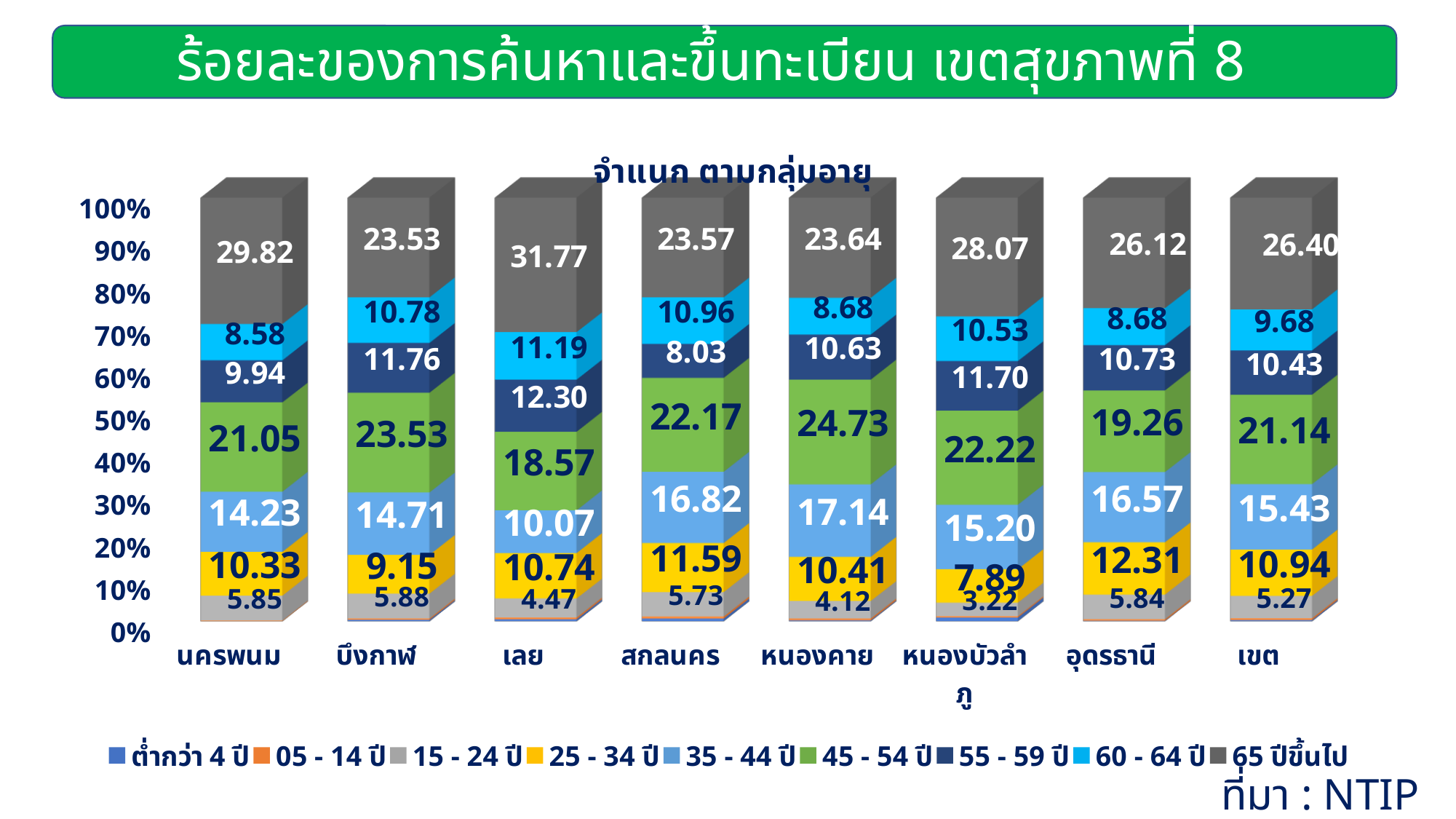
Which has the larger 35 - 44 ปี value, หนองคาย or สกลนคร? หนองคาย How many series does the legend list? 9 Which category has the lowest value for the 15 - 24 ปี series? หนองบัวลำภู Which category has the highest value for the 35 - 44 ปี series? หนองคาย What is the difference between the 45 - 54 ปี values for บึงกาฬ and เลย? 4.96 How many categories are shown on the x axis? 8 What is the value for the 65 ปีขึ้นไป series for เลย? 31.77 What kind of chart is shown on the slide? Stacked bar chart What is the value for the 25 - 34 ปี series for อุดรธานี? 12.31 Which category has the highest value for the 65 ปีขึ้นไป series? เลย What is the subtitle printed above the chart? จำแนก ตามกลุ่มอายุ What is the value for the 45 - 54 ปี series for หนองคาย? 24.73